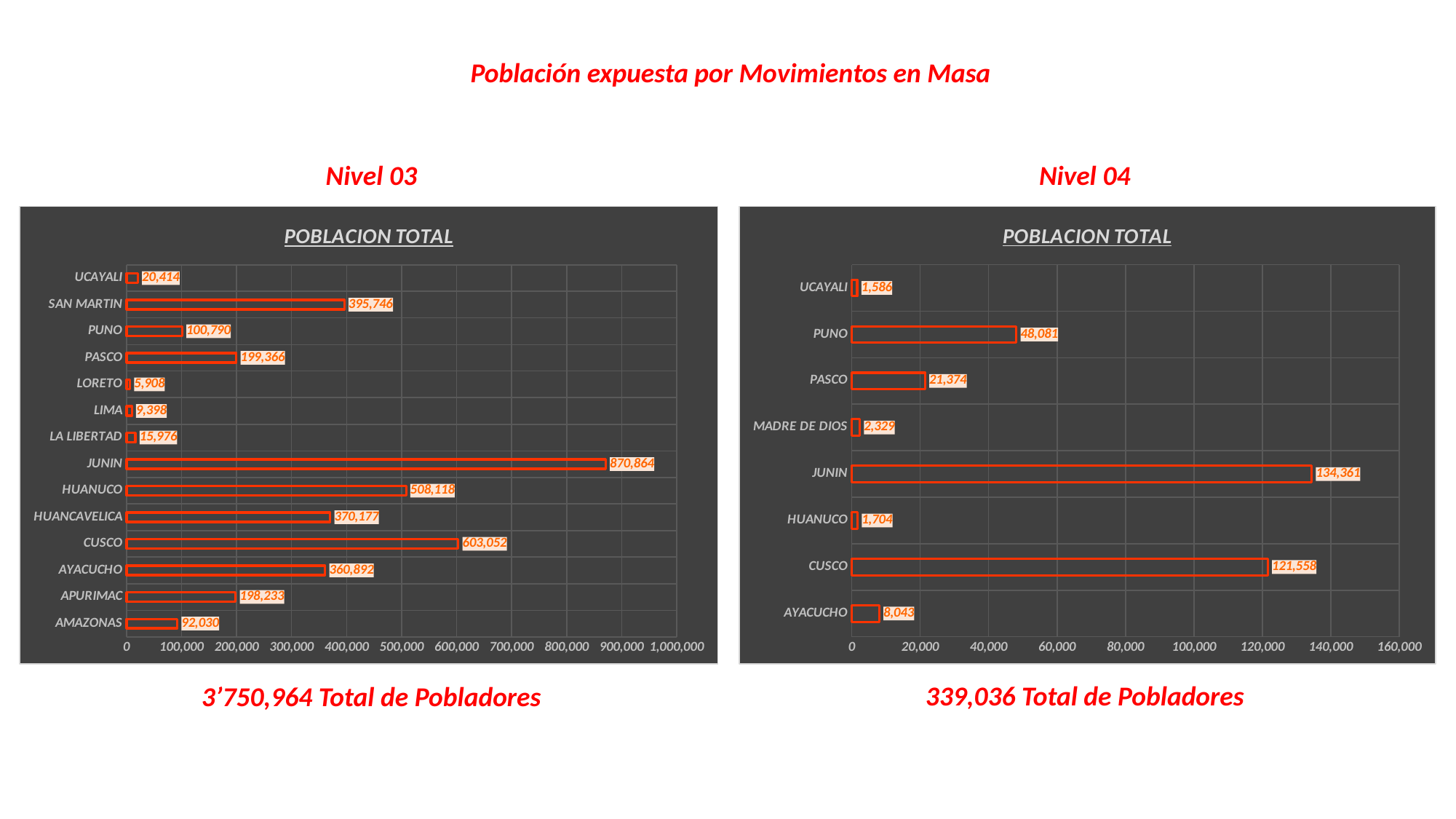
In the Nivel 04 chart, what is the value for MADRE DE DIOS? 2,329 In the Nivel 03 chart, what is the value for JUNIN? 870,864 How many regions are shown in the Nivel 04 chart? 8 In the Nivel 04 chart, which region has the highest value? JUNIN In the Nivel 03 chart, what is the difference between the values for CUSCO and HUANUCO? 94,934 In the Nivel 03 chart, which region has the lowest value? LORETO In the Nivel 04 chart, what is the value for PUNO? 48,081 In the Nivel 04 chart, what is the difference between the values for JUNIN and CUSCO? 12,803 In the Nivel 03 chart, which is larger, the value for HUANCAVELICA or the value for AYACUCHO? HUANCAVELICA In the Nivel 04 chart, which region has the lowest value? UCAYALI In the Nivel 03 chart, what is the value for SAN MARTIN? 395,746 What type of chart is the Nivel 03 chart? Bar chart